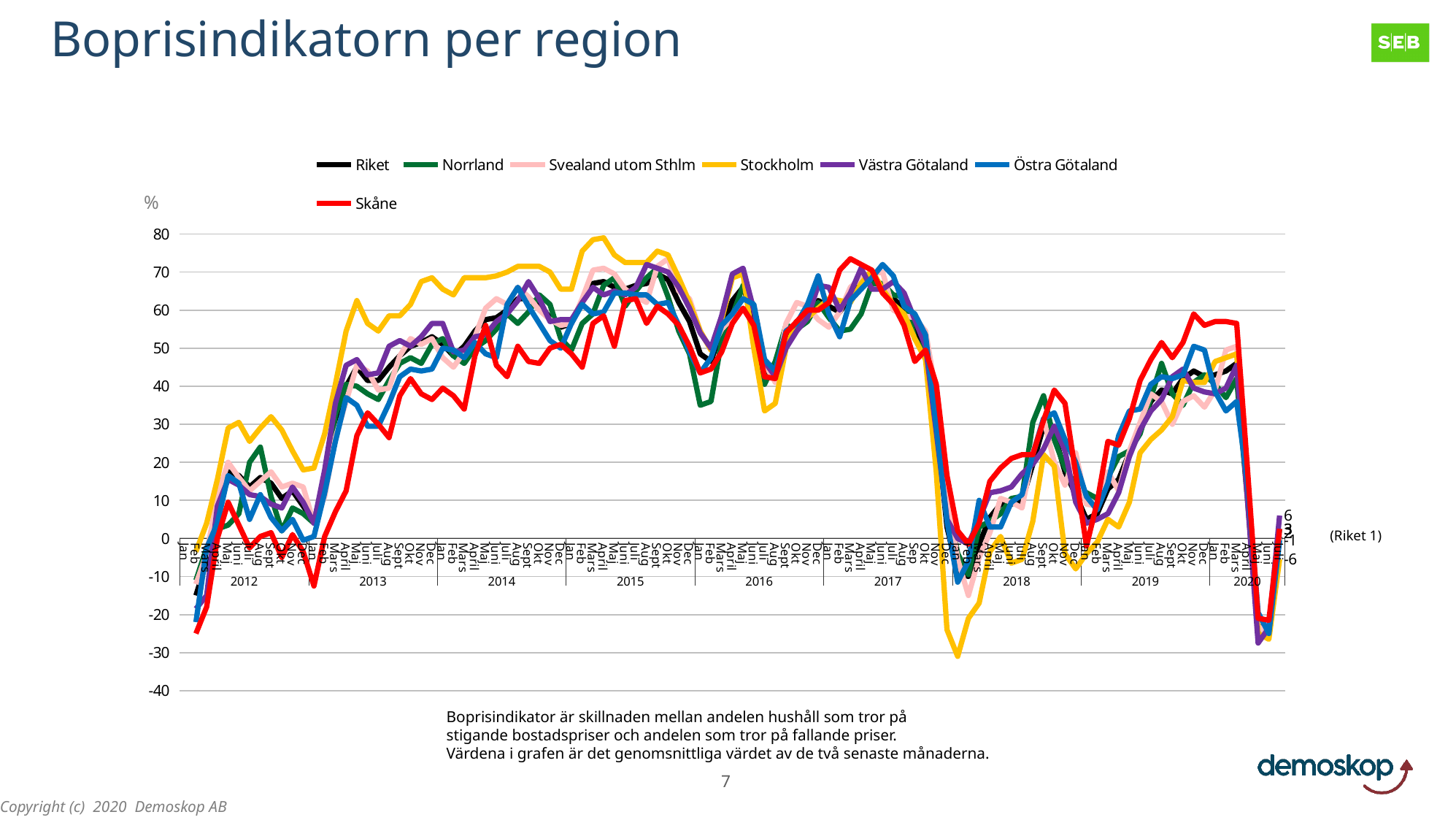
Do the values generally rise or fall from 2012 to 2015? rise During 2012, which series is higher, Stockholm or Skåne? Stockholm Which series reaches the highest value anywhere on the chart? Stockholm What is the highest tick value shown on the y axis? 80 How many series does the legend list? 7 Is the value for Skåne at the start of 2012 greater or less than -20? less What is the latest value for Riket, as annotated on the chart? 1 Which series reaches the lowest value anywhere on the chart? Stockholm Is the peak value for Stockholm in early 2015 greater or less than 70? greater What kind of chart is shown on the slide? line chart Is the lowest value for Stockholm around the start of 2018 greater or less than -20? less What is the title of the chart? Boprisindikatorn per region